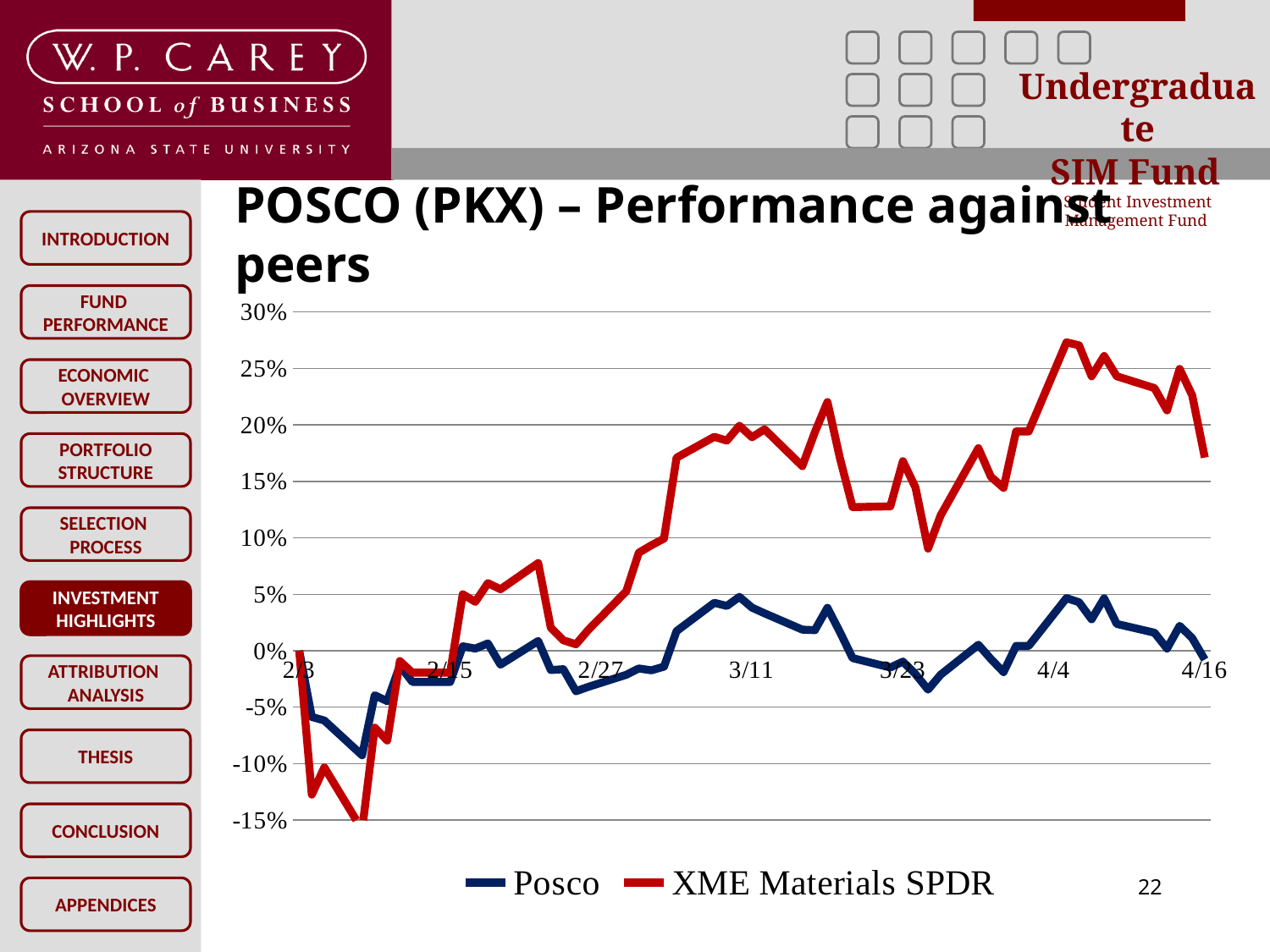
What are the two series named in the legend? Posco and XME Materials SPDR How many date labels are shown on the x axis? 7 Is the value for XME Materials SPDR at 3/23 greater or less than 10%? greater What is the title of the chart on the slide? POSCO (PKX) – Performance against peers What kind of chart is shown on the slide? line chart At 4/16, which series has the higher value, Posco or XME Materials SPDR? XME Materials SPDR At 3/11, which series has the higher value, Posco or XME Materials SPDR? XME Materials SPDR How many series does the legend list? 2 Is the lowest value for Posco (near the start of the period) greater or less than -5%? less Does the XME Materials SPDR line overall rise or fall from 2/3 to 4/16? rise Is the value for XME Materials SPDR at 4/16 greater or less than 15%? greater